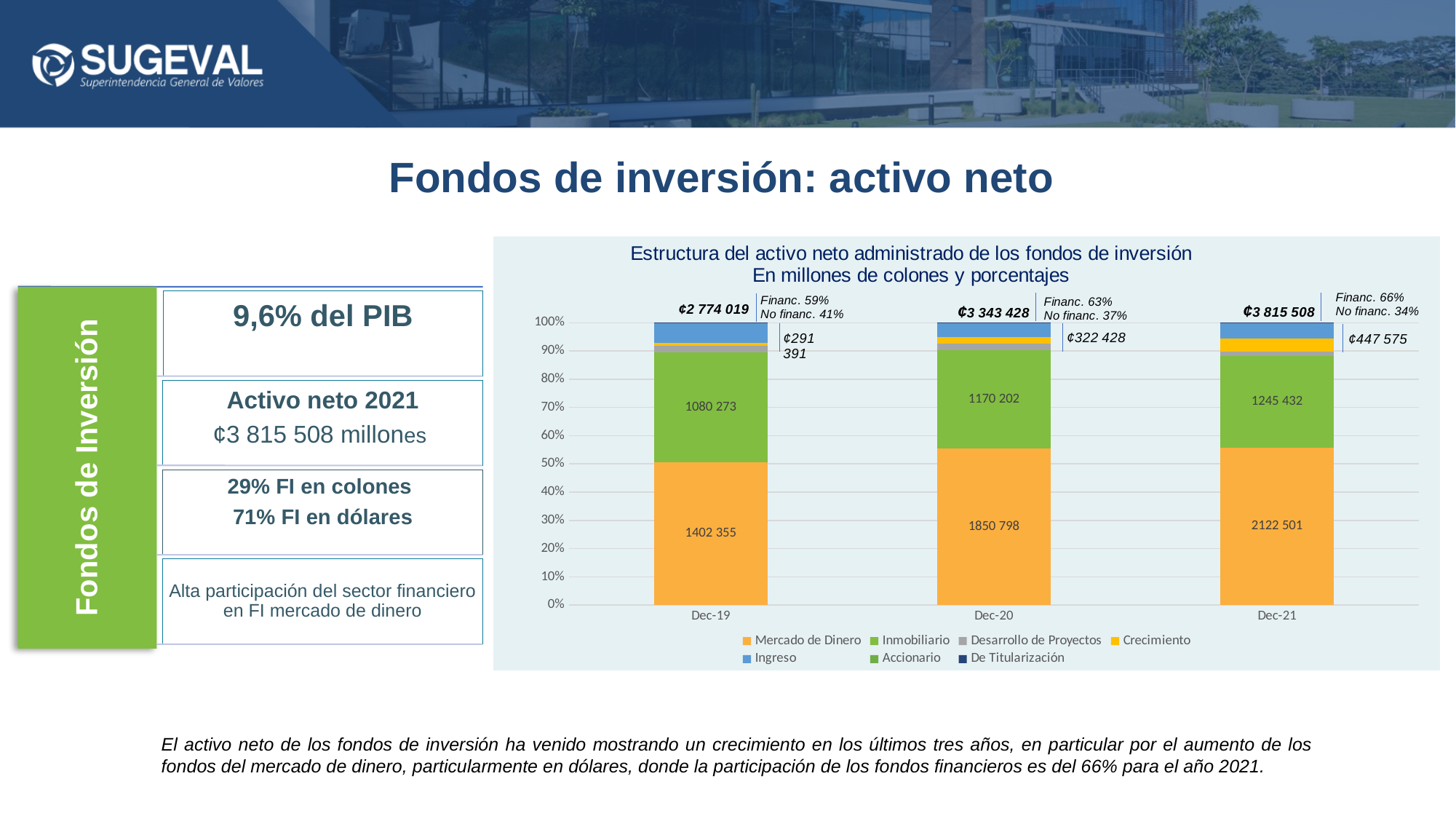
How many series does the chart legend list? 7 What is the value of Inmobiliario for Dec-19? 1080 273 Which is larger in Dec-20: Mercado de Dinero or Inmobiliario? Mercado de Dinero What is the value of Mercado de Dinero for Dec-21? 2122 501 What is the difference between the Mercado de Dinero values for Dec-21 and Dec-20? 271 703 What type of chart is shown on the slide? Stacked bar chart In which period is the Mercado de Dinero value the highest? Dec-21 How many time periods (categories) are shown on the x axis of the chart? 3 Does the Mercado de Dinero value rise or fall from Dec-19 to Dec-21? Rise What percentage share is labelled as 'Financ.' for Dec-21? 66% What is the total net asset value shown above the Dec-20 bar? ₡3 343 428 In which period is the Inmobiliario value the lowest? Dec-19